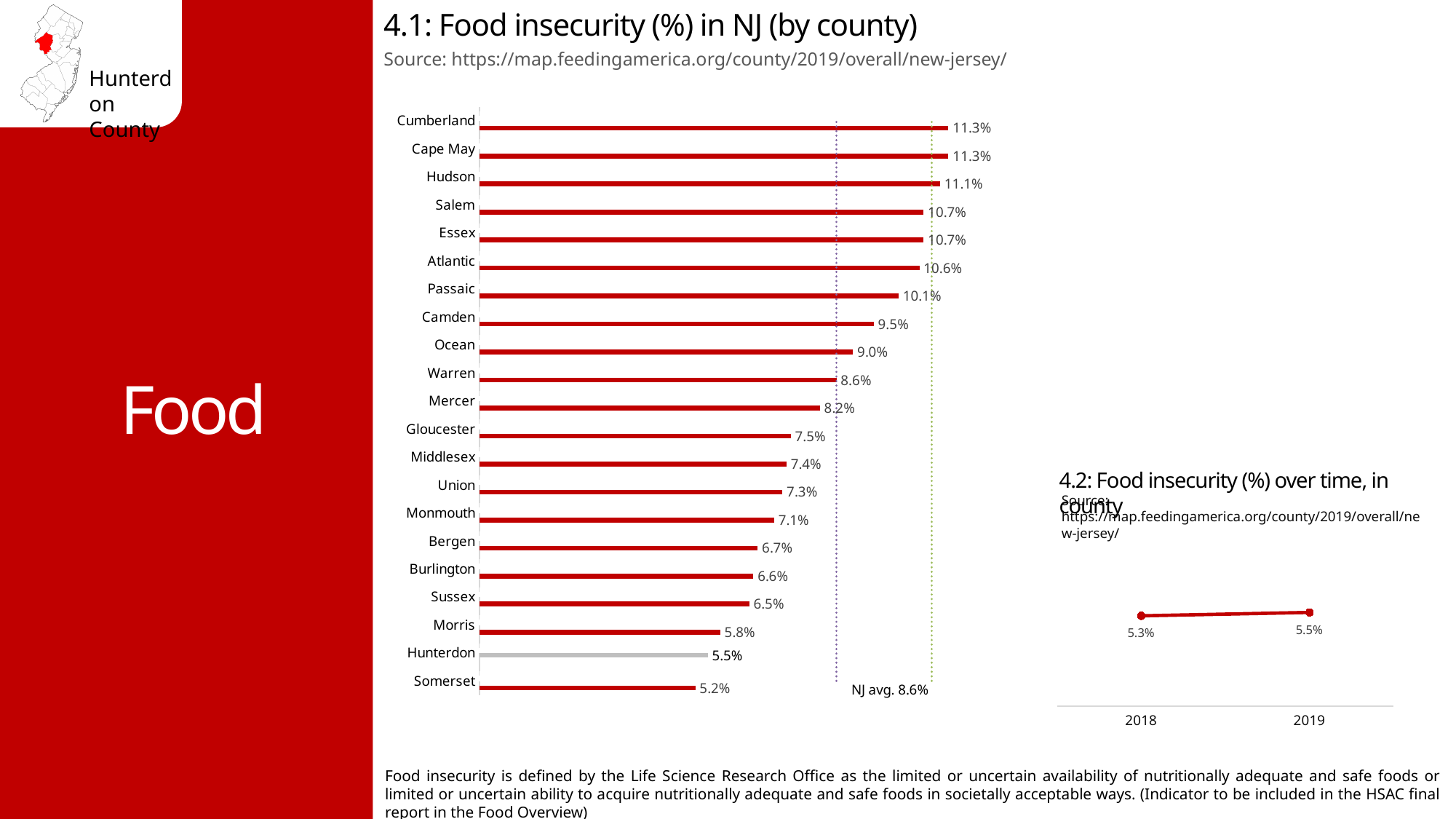
In chart 4.1 (Food insecurity (%) in NJ by county), what NJ average value is labelled on the chart? 8.6% In chart 4.2 (Food insecurity (%) over time, in county), what is the difference between 2019 and 2018? 0.2% In chart 4.2 (Food insecurity (%) over time, in county), does the value rise or fall from 2018 to 2019? Rise In chart 4.1 (Food insecurity (%) in NJ by county), how many counties are shown? 21 In chart 4.1 (Food insecurity (%) in NJ by county), which is larger, Camden or Ocean? Camden In chart 4.1 (Food insecurity (%) in NJ by county), what is the difference between Cumberland and Somerset? 6.1% In chart 4.1 (Food insecurity (%) in NJ by county), what is the value for Passaic? 10.1% In chart 4.2 (Food insecurity (%) over time, in county), what is the value for 2019? 5.5% What kind of chart is chart 4.1 (Food insecurity (%) in NJ by county)? Bar chart In chart 4.1 (Food insecurity (%) in NJ by county), which county has the lowest food insecurity? Somerset In chart 4.1 (Food insecurity (%) in NJ by county), what is the difference between Hunterdon and the NJ average of 8.6%? 3.1% In chart 4.1 (Food insecurity (%) in NJ by county), what is the value for Hunterdon? 5.5%